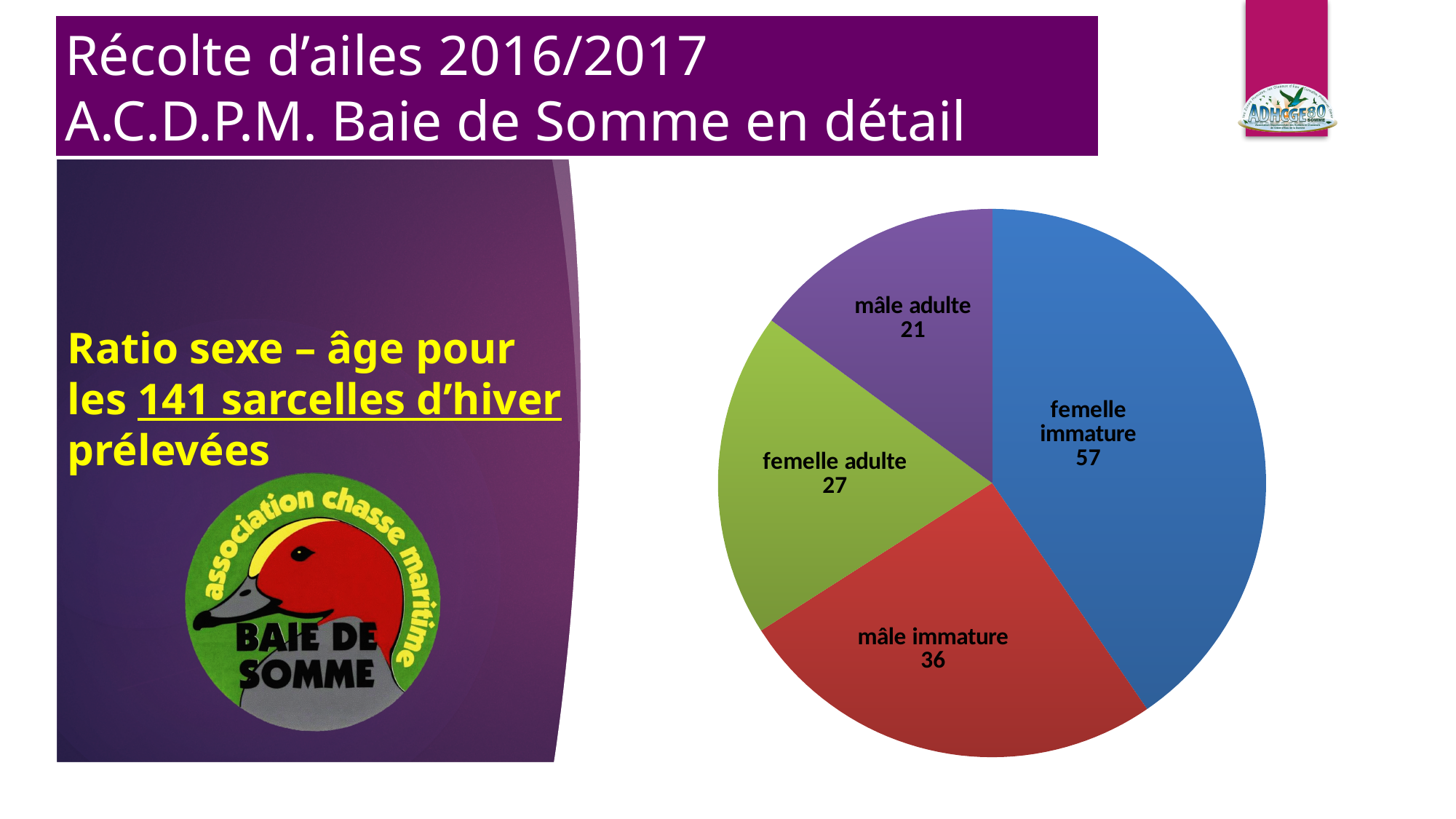
What is the value for femelle immature in the pie chart? 57 Which is larger, the value for femelle adulte or the value for mâle adulte? femelle adulte What is the value for mâle adulte in the pie chart? 21 What is the value for femelle adulte in the pie chart? 27 What colour is the femelle immature slice in the pie chart? blue What kind of chart is shown on the slide? pie chart What is the total of all four slices in the pie chart? 141 How many slices does the pie chart have? 4 What is the value for mâle immature in the pie chart? 36 What is the difference between the values for femelle immature and mâle immature? 21 Which category has the largest slice in the pie chart? femelle immature Which category has the smallest slice in the pie chart? mâle adulte